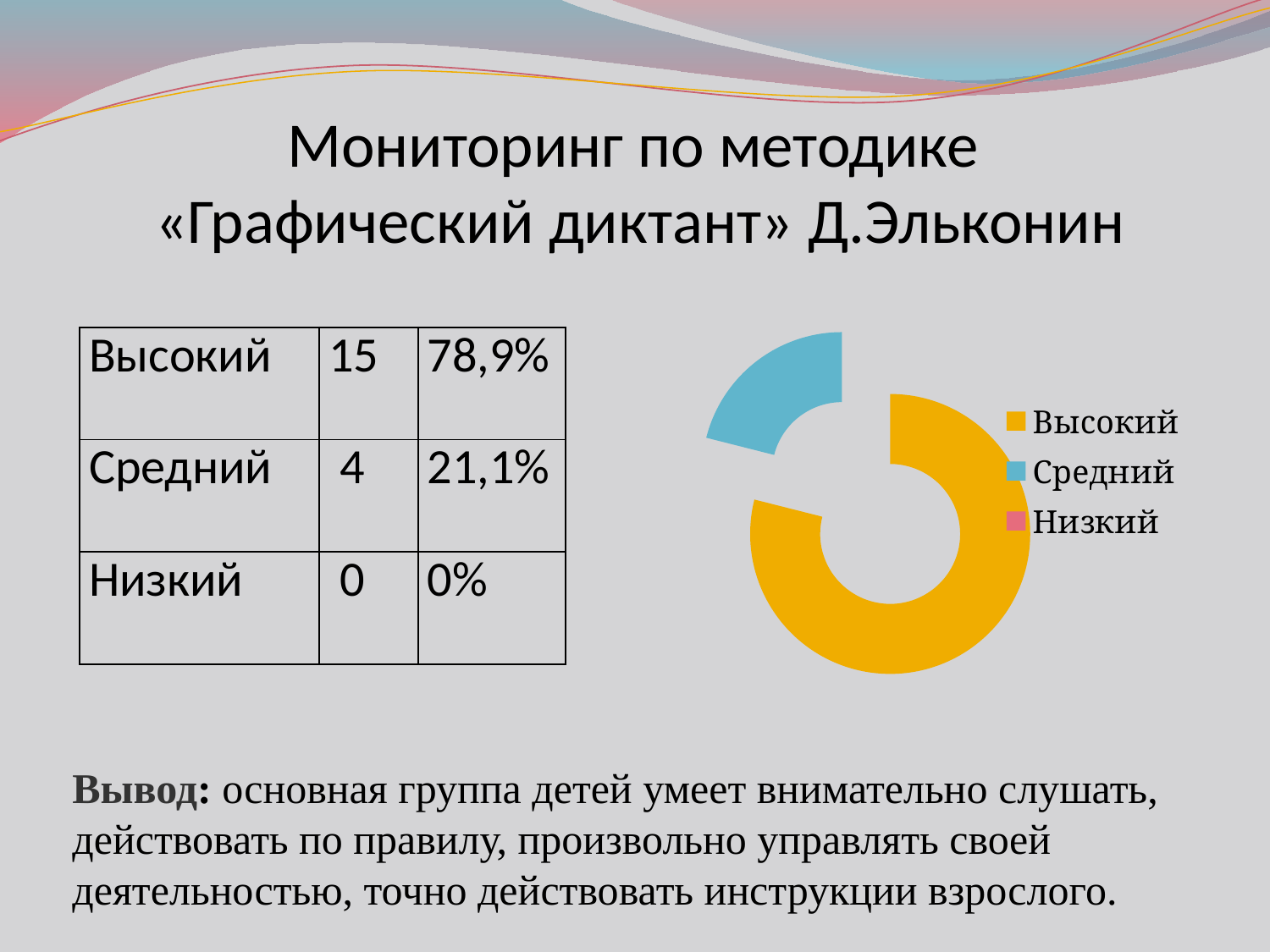
What colour represents Высокий in the chart? Yellow According to the table on the slide, what percentage corresponds to Высокий? 78,9% According to the table on the slide, what percentage corresponds to Средний? 21,1% What is the difference in percentage points between Высокий and Средний as shown in the table? 57,8 Which is larger in the chart, the share for Высокий or for Средний? Высокий Which category takes up the largest share of the doughnut chart? Высокий According to the table on the slide, how many children are in the Высокий group? 15 What kind of chart is shown on the slide? Doughnut chart What colour represents Средний in the chart? Blue How many entries does the chart legend list? 3 According to the table on the slide, how many children are in the Низкий group? 0 Which category has the smallest share in the chart? Низкий